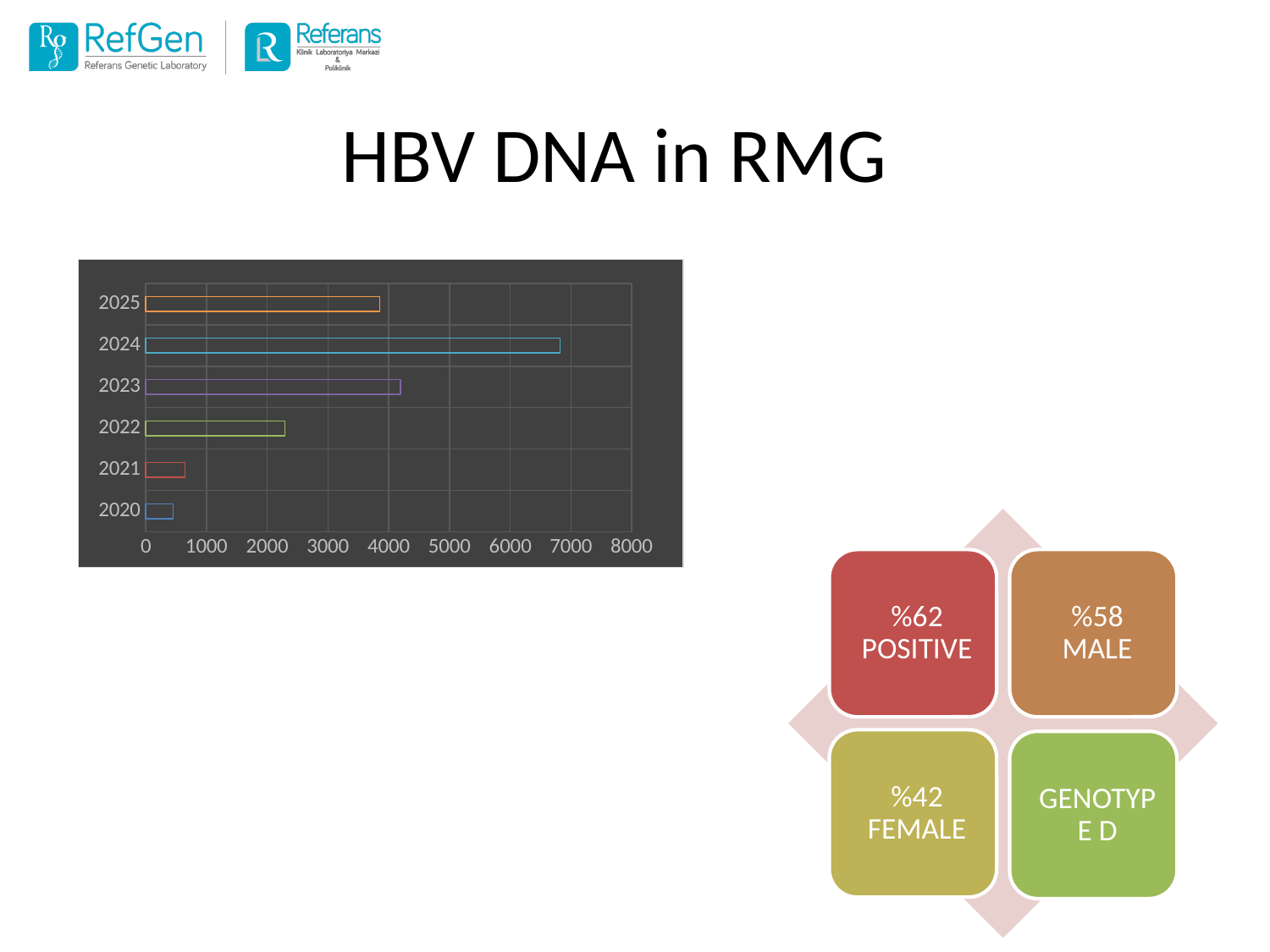
Is the value for 2025 greater or less than 3000? greater Which year has the highest value on the chart? 2024 How many years are shown on the chart? 6 What kind of chart is shown on the slide? bar chart Is the value for 2021 greater or less than 1000? less Is the value for 2022 greater or less than 2000? greater Which year has the larger value, 2024 or 2025? 2024 What is the highest value shown on the horizontal axis of the chart? 8000 Which year has the lowest value on the chart? 2020 Do the values rise or fall from 2020 to 2024? rise